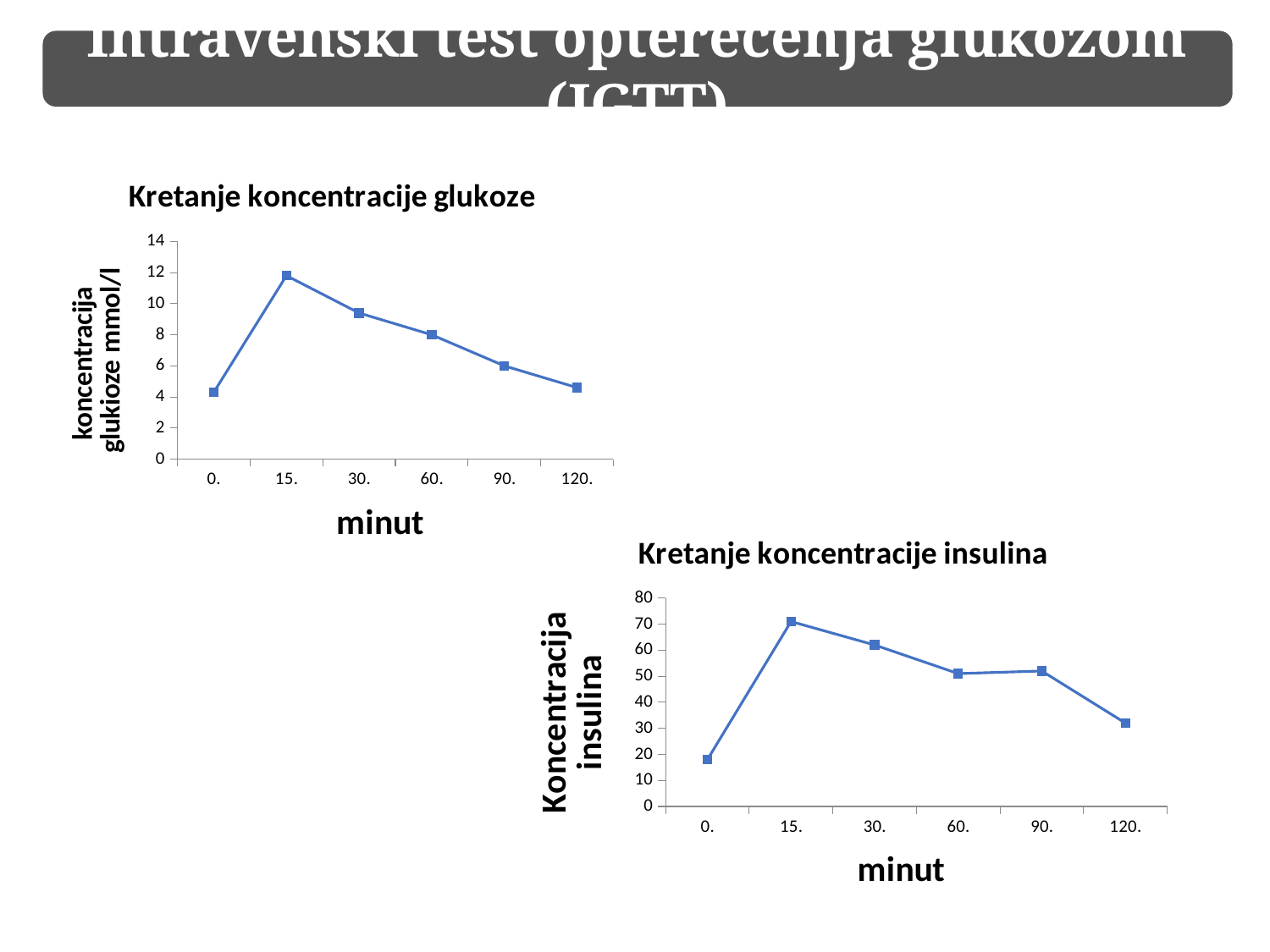
In the 'Kretanje koncentracije glukoze' chart, how many data points are plotted? 6 In the 'Kretanje koncentracije insulina' chart, at which minute is the insulin concentration highest? 15. In the 'Kretanje koncentracije insulina' chart, at which minute is the insulin concentration lowest? 0. In the 'Kretanje koncentracije glukoze' chart, is the value at 15. minutes greater or less than 10? greater In the 'Kretanje koncentracije insulina' chart, is the value at 15. minutes greater or less than 60? greater In the 'Kretanje koncentracije glukoze' chart, at which minute is the glucose concentration highest? 15. What is the x-axis title of the 'Kretanje koncentracije insulina' chart? minut In the 'Kretanje koncentracije glukoze' chart, which is larger, the value at 30. minutes or at 60. minutes? 30. In the 'Kretanje koncentracije glukoze' chart, is the value at 0. minutes greater or less than 6? less In the 'Kretanje koncentracije glukoze' chart, do the values rise or fall from 15. to 120. minutes? fall What type of chart is 'Kretanje koncentracije glukoze'? line chart